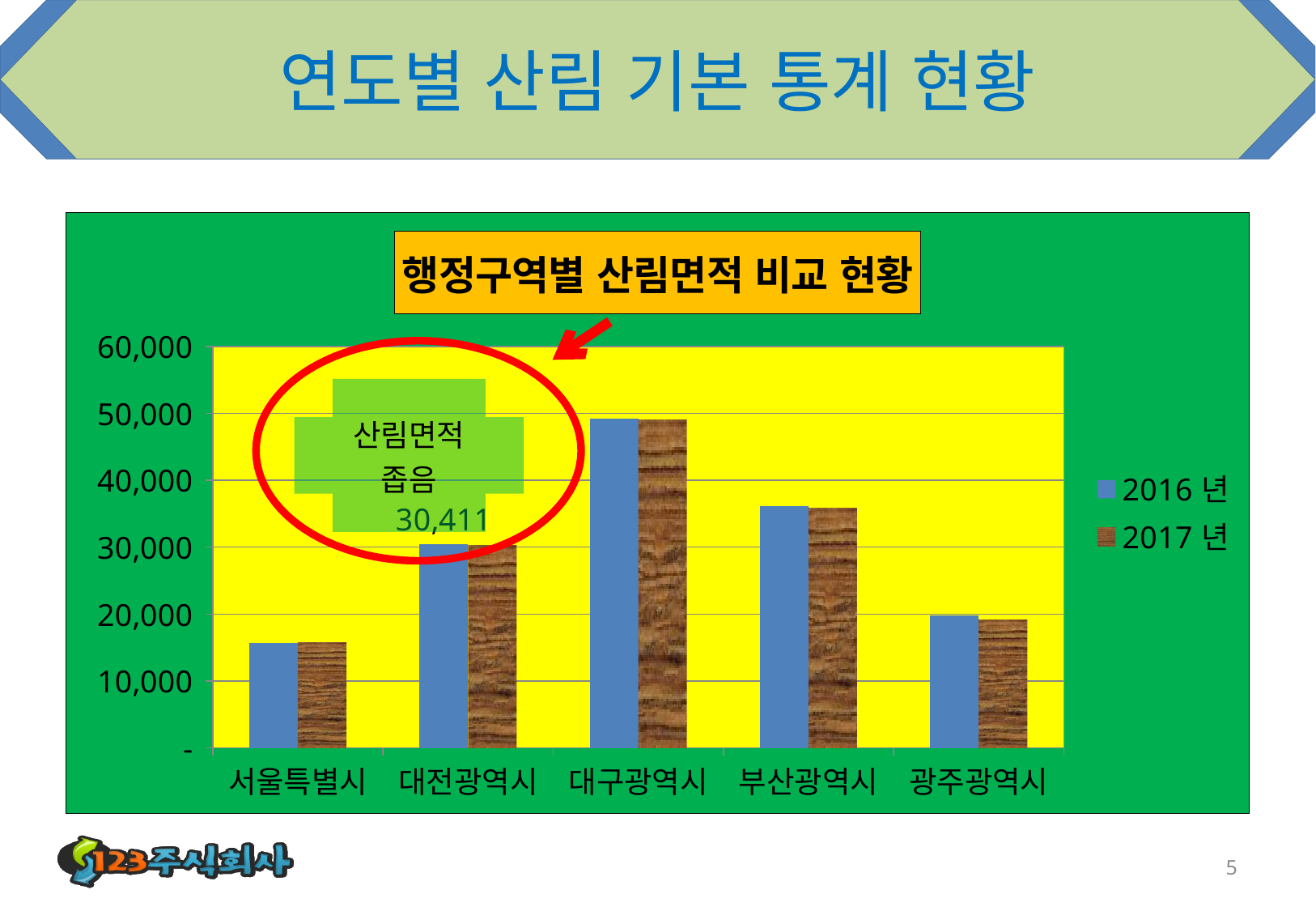
What value is printed in the callout label attached to the 대전광역시 bar? 30,411 How many administrative regions (categories) are shown on the x axis? 5 Which region has the lowest forest area in the chart? 서울특별시 Is the 2016 년 value for 대구광역시 greater or less than 40,000? greater Which has a larger 2016 년 value, 부산광역시 or 광주광역시? 부산광역시 What are the two entries listed in the chart legend? 2016 년, 2017 년 How many series does the legend list? 2 What is the title of the chart? 행정구역별 산림면적 비교 현황 What kind of chart is shown on the slide? bar chart Is the 2016 년 value for 서울특별시 greater or less than 20,000? less Is the 2017 년 value for 부산광역시 greater or less than 30,000? greater Which region has the highest forest area in the chart? 대구광역시